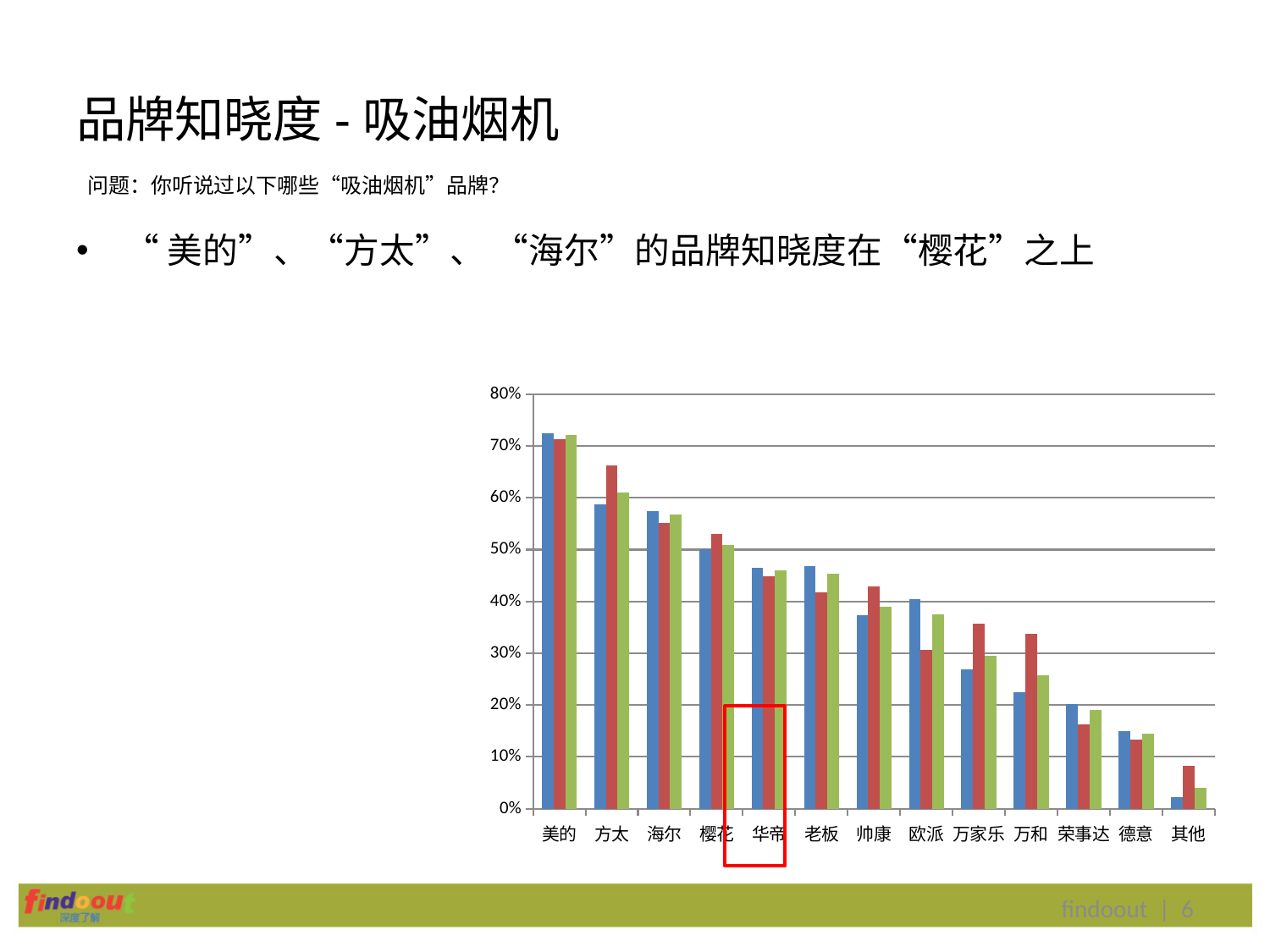
How many bars (series) are plotted for each brand in the chart? 3 Which brand has the highest awareness values in the chart? 美的 Is the red bar for 方太 greater or less than 60%? greater What kind of chart is shown on the slide? bar chart Is the blue bar for 其他 greater or less than 10%? less Which category has the lowest values in the chart? 其他 Do the values generally rise or fall moving from left to right along the x axis? fall Is the blue bar for 美的 greater or less than 60%? greater How many brand categories are shown on the x axis of the chart? 13 Which brand on the x axis is highlighted with a red box? 华帝 Which is larger, the red bar for 方太 or the red bar for 海尔? 方太